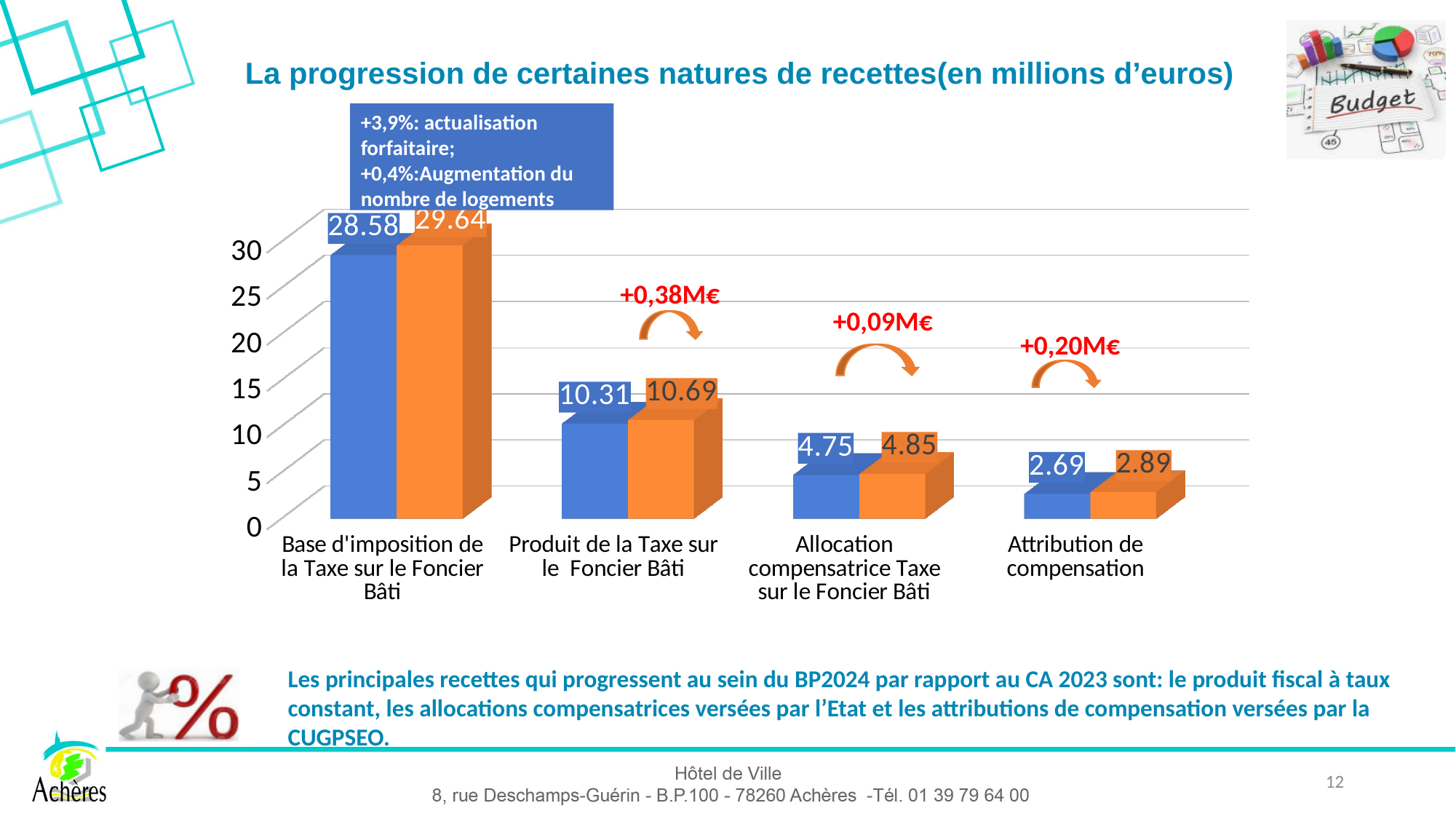
What is the value of the blue bar for "Allocation compensatrice Taxe sur le Foncier Bâti"? 4.75 How many categories are shown on the x axis? 4 What is the title of the slide's chart? La progression de certaines natures de recettes(en millions d'euros) What is the difference between the orange and blue bars for "Attribution de compensation"? 0.20 What is the difference between the orange and blue bars for "Base d'imposition de la Taxe sur le Foncier Bâti"? 1.06 What is the value of the blue bar for "Base d'imposition de la Taxe sur le Foncier Bâti"? 28.58 Which is larger for "Produit de la Taxe sur le Foncier Bâti": the blue bar or the orange bar? the orange bar What is the value of the orange bar for "Attribution de compensation"? 2.89 Which category has the lowest blue bar? Attribution de compensation What is the value of the orange bar for "Produit de la Taxe sur le Foncier Bâti"? 10.69 What kind of chart is shown on the slide? bar chart Which category has the highest orange bar? Base d'imposition de la Taxe sur le Foncier Bâti